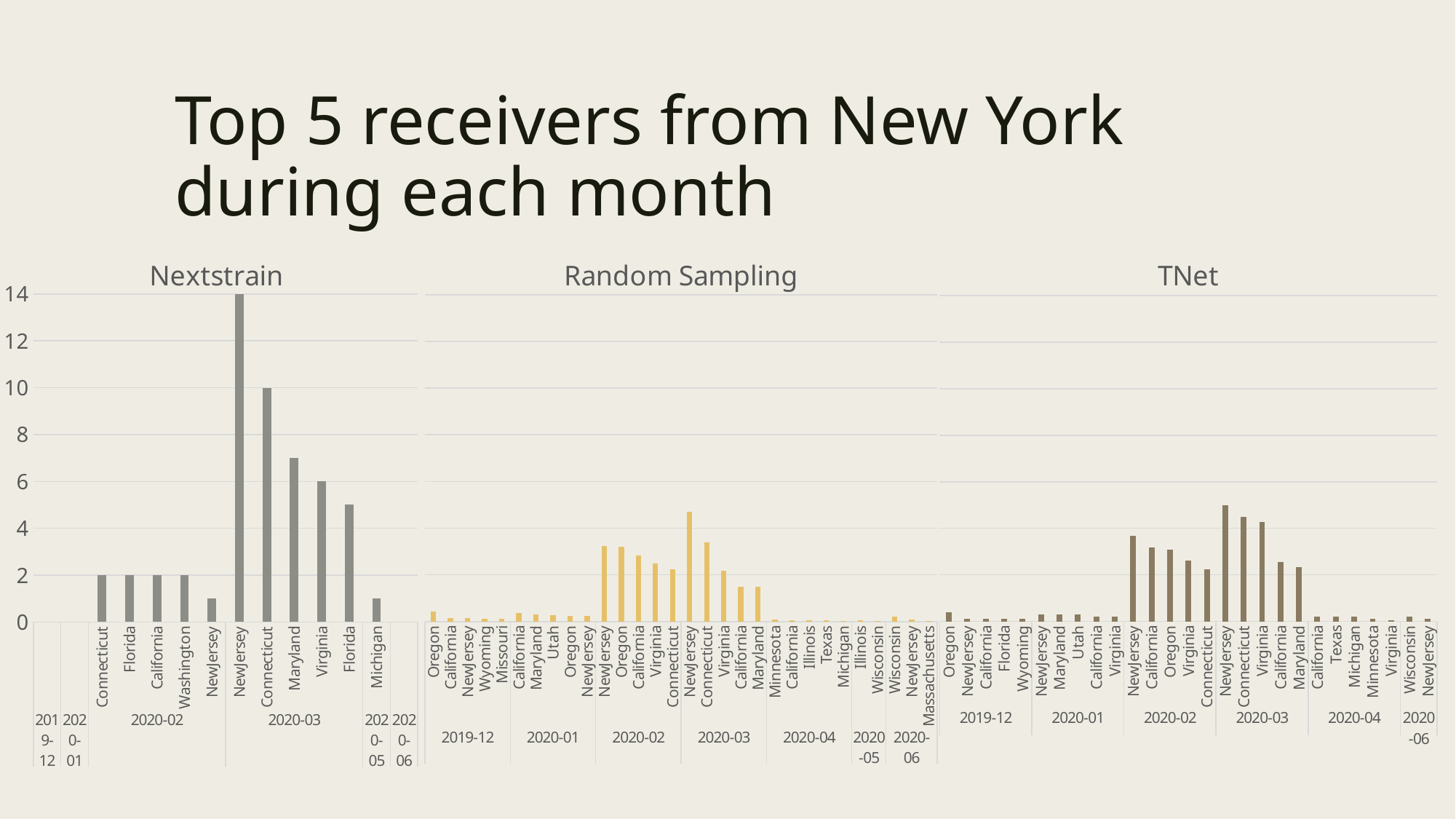
What is the title of the rightmost chart? TNet In the TNet chart, is the value for NewJersey in 2020-02 greater or less than 2? greater In the Nextstrain chart, which is larger in 2020-03, Maryland or Virginia? Maryland How many charts are shown on the slide? 3 In the Nextstrain chart, what is the value for Connecticut in 2020-02? 2 In the Nextstrain chart, what is the value for Virginia in 2020-03? 6 In the Nextstrain chart, what is the value for NewJersey in 2020-03? 14 In the Nextstrain chart, which bar is the highest? NewJersey (2020-03) In the Random Sampling chart, is the value for NewJersey in 2020-03 greater or less than 4? greater What kind of chart is the Nextstrain chart? bar chart In the Nextstrain chart, what is the difference between NewJersey and Connecticut in 2020-03? 4 In the Nextstrain chart, what is the value for Connecticut in 2020-03? 10